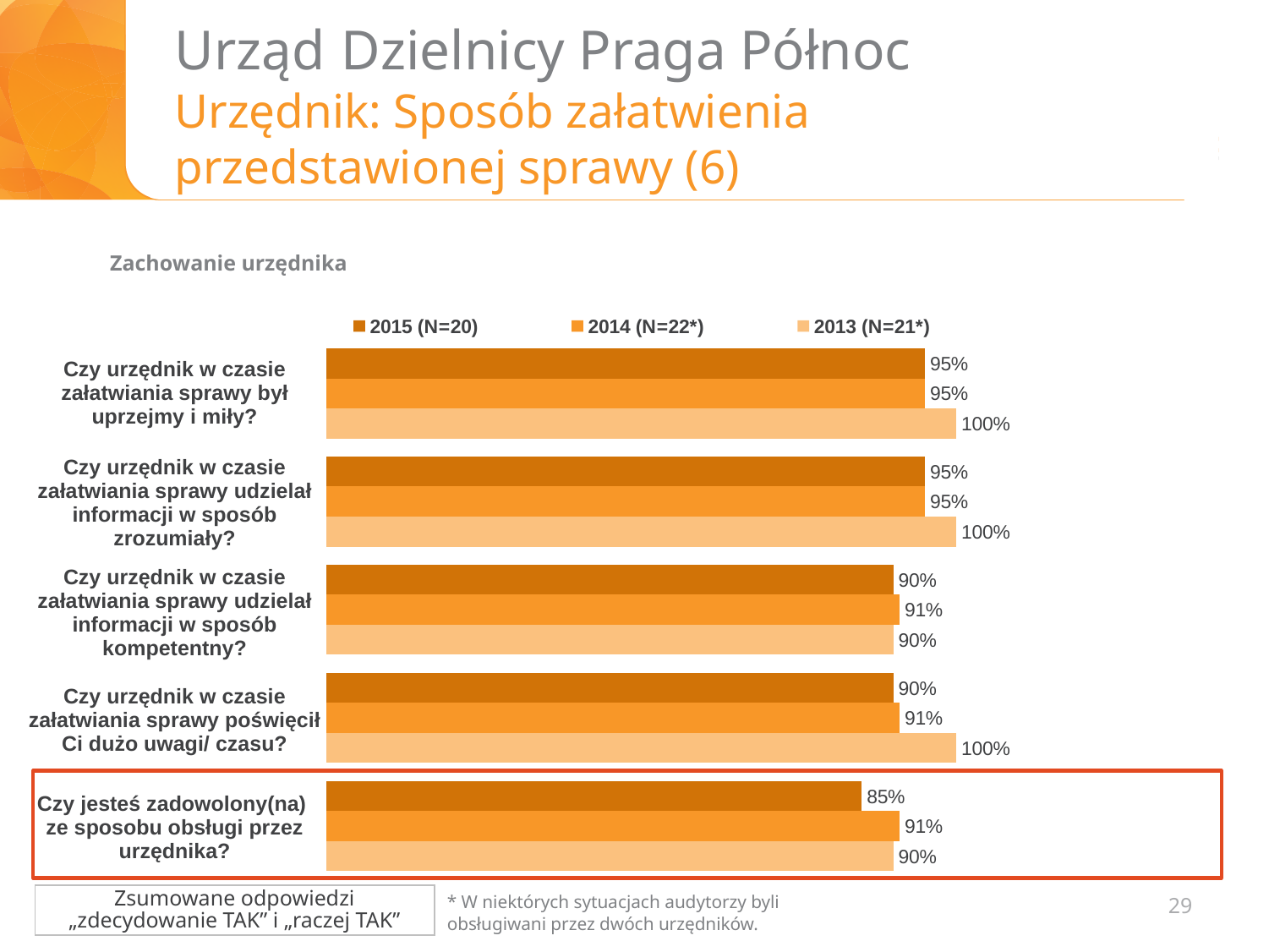
How many question categories are plotted on the chart? 5 What is the 2013 (N=21*) value for "Czy urzędnik w czasie załatwiania sprawy poświęcił Ci dużo uwagi/ czasu?"? 100% What is the difference between the 2013 (N=21*) and 2015 (N=20) values for "Czy urzędnik w czasie załatwiania sprawy poświęcił Ci dużo uwagi/ czasu?"? 10% Which category has the lowest 2015 (N=20) value? Czy jesteś zadowolony(na) ze sposobu obsługi przez urzędnika? What is the difference between the 2014 (N=22*) and 2015 (N=20) values for "Czy jesteś zadowolony(na) ze sposobu obsługi przez urzędnika?"? 6% How many series does the legend list? 3 What is the 2014 (N=22*) value for "Czy urzędnik w czasie załatwiania sprawy udzielał informacji w sposób kompetentny?"? 91% What is the 2015 (N=20) value for "Czy jesteś zadowolony(na) ze sposobu obsługi przez urzędnika?"? 85% Which category is highlighted with a red outline on the chart? Czy jesteś zadowolony(na) ze sposobu obsługi przez urzędnika? What kind of chart is shown on the slide? bar chart What is the 2015 (N=20) value for "Czy urzędnik w czasie załatwiania sprawy udzielał informacji w sposób zrozumiały?"? 95% For "Czy urzędnik w czasie załatwiania sprawy był uprzejmy i miły?", which series has the larger value: 2015 (N=20) or 2013 (N=21*)? 2013 (N=21*)